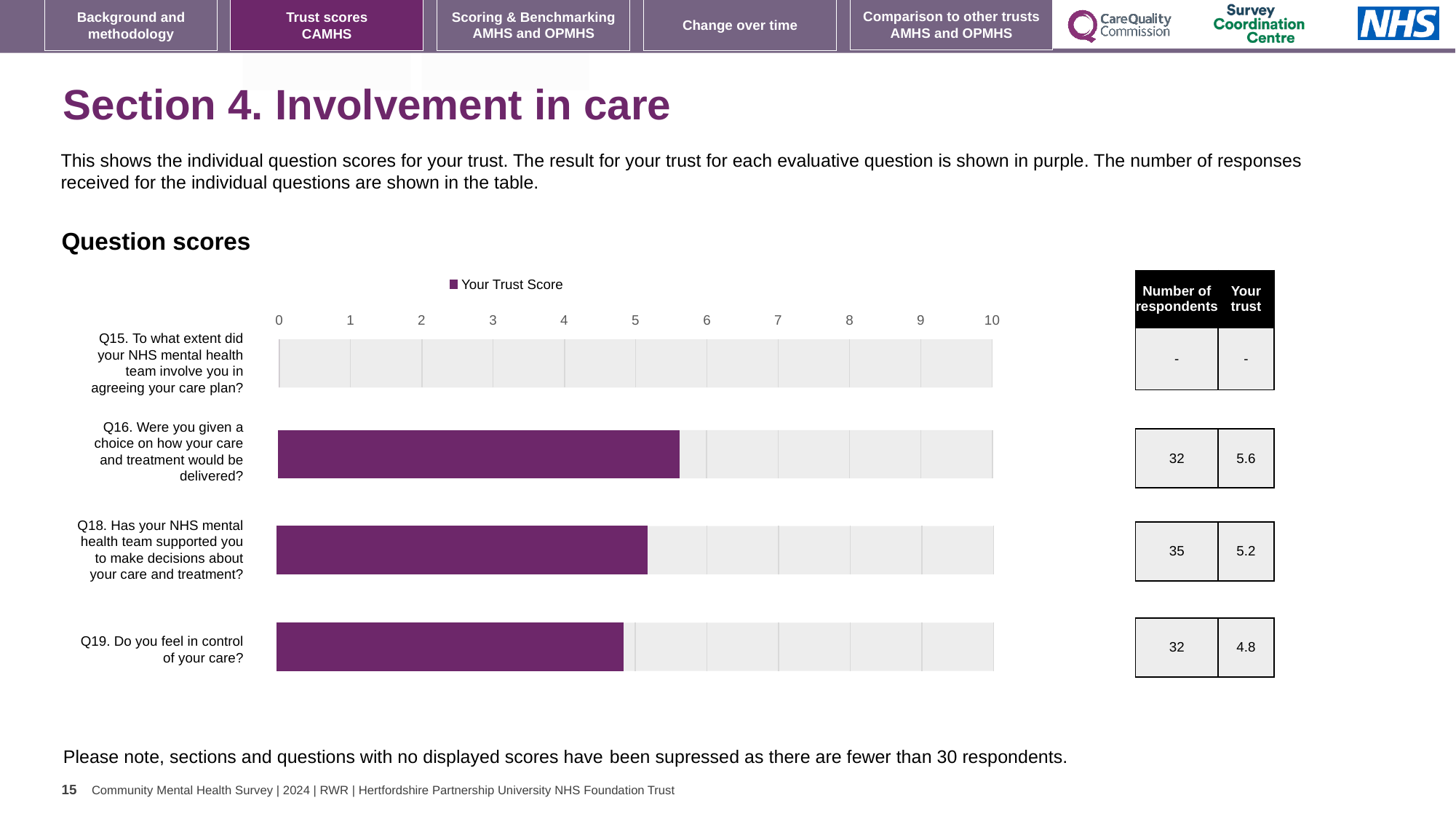
Which question has the highest Your Trust Score on the chart? Q16 What is the difference between the Your Trust Score for Q16 and for Q19? 0.8 How many questions are listed on the chart? 4 What is the Your Trust Score for Q16 (Were you given a choice on how your care and treatment would be delivered?)? 5.6 Among the questions with a displayed score, which has the lowest Your Trust Score? Q19 How many series does the chart legend list? 1 What is the Your Trust Score for Q19 (Do you feel in control of your care?)? 4.8 Which has a larger Your Trust Score, Q18 or Q19? Q18 Is the Your Trust Score for Q16 greater or less than 5? greater What kind of chart is shown under Question scores? bar chart What is the Your Trust Score for Q18 (Has your NHS mental health team supported you to make decisions about your care and treatment?)? 5.2 What is the name of the series shown in the chart legend? Your Trust Score